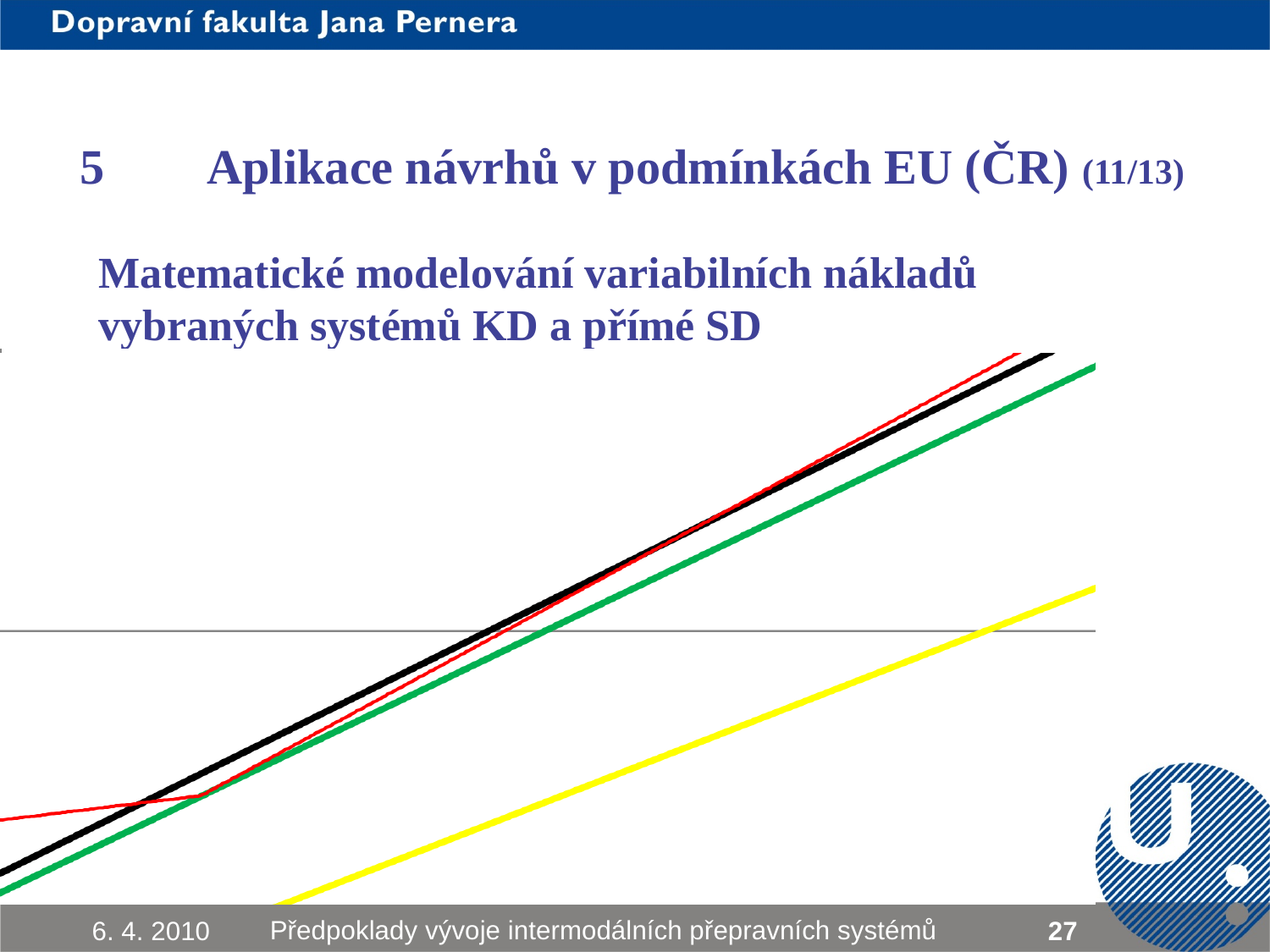
Which coloured line lies lowest on the chart across its whole length? yellow At the right edge of the chart, is the green line above or below the black line? below What kind of chart is shown on the slide? line chart How many lines are plotted on the chart? 4 Do the plotted lines rise or fall from left to right along the x axis? rise